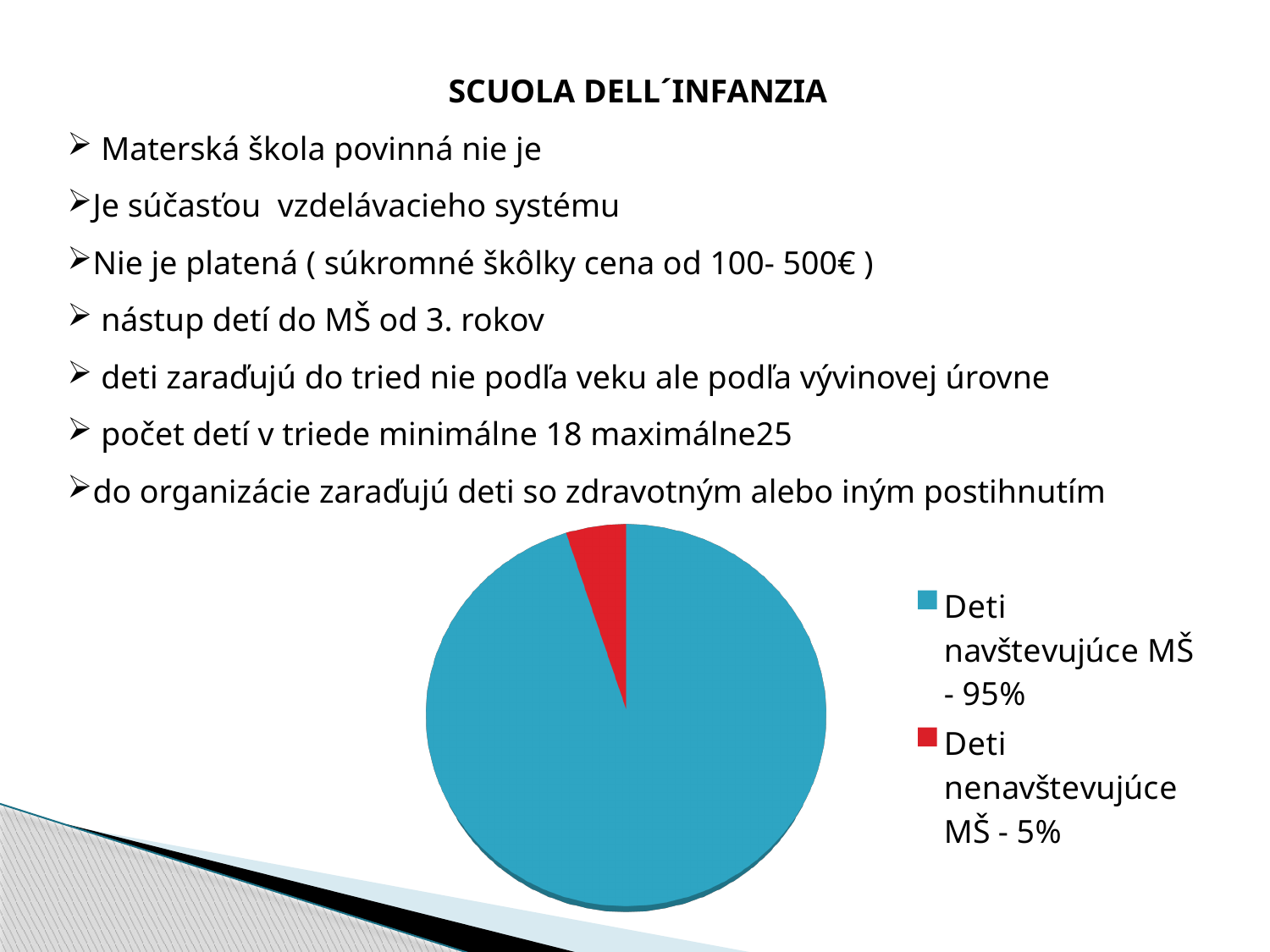
What colour is the slice for 'Deti nenavštevujúce MŠ' in the pie chart? red What is the difference in percentage points between the 'Deti navštevujúce MŠ' slice and the 'Deti nenavštevujúce MŠ' slice? 90 What is the total of the two percentages shown in the pie chart legend? 100% Which slice of the pie chart is the largest? Deti navštevujúce MŠ Which is larger: the share for 'Deti navštevujúce MŠ' or the share for 'Deti nenavštevujúce MŠ'? Deti navštevujúce MŠ How many entries does the legend of the pie chart list? 2 What kind of chart is shown on the slide? pie chart Which slice of the pie chart is the smallest? Deti nenavštevujúce MŠ What share of the pie is labelled for 'Deti nenavštevujúce MŠ'? 5% How many slices does the pie chart have? 2 What colour is the slice for 'Deti navštevujúce MŠ' in the pie chart? blue What share of the pie is labelled for 'Deti navštevujúce MŠ'? 95%